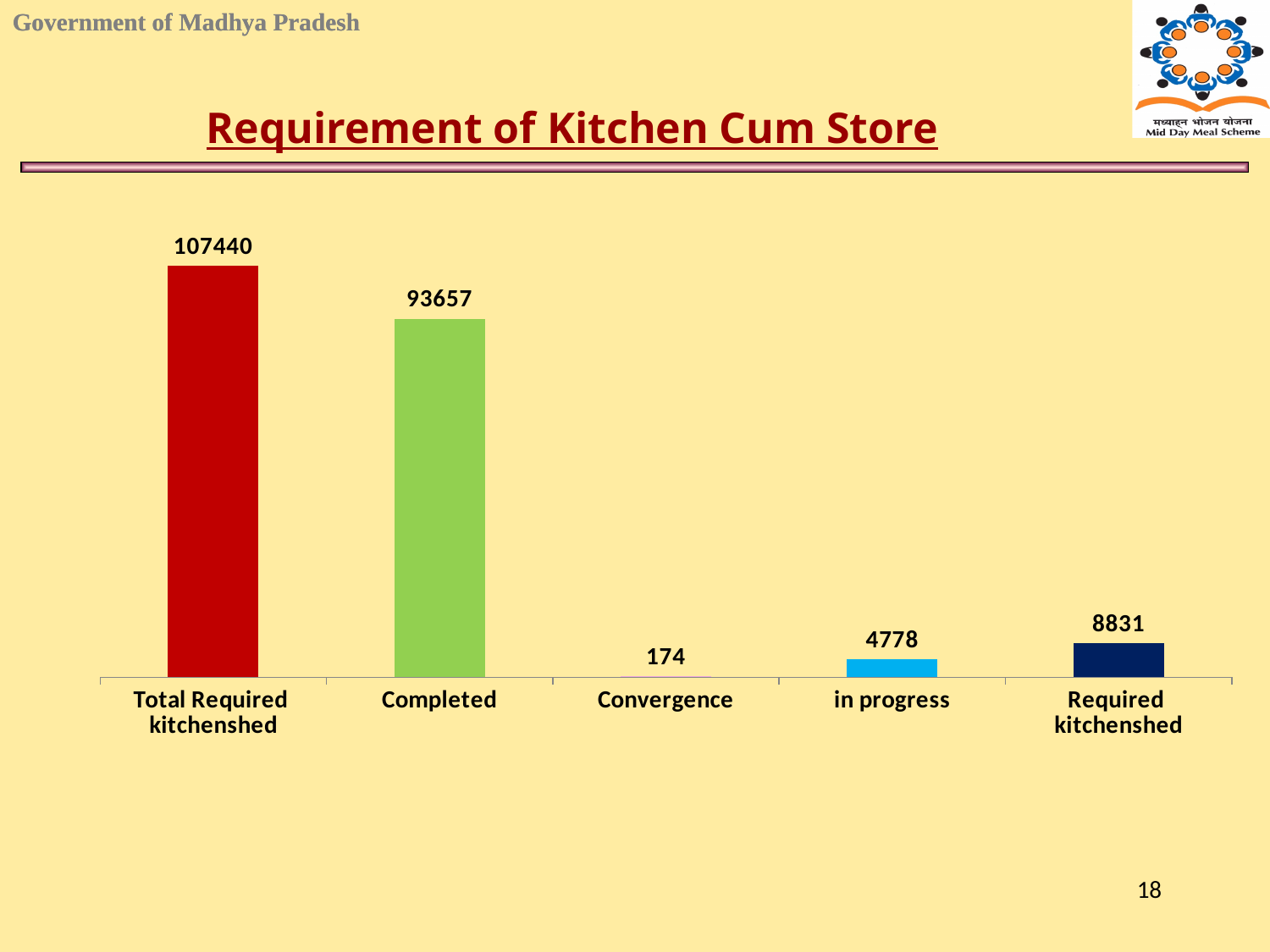
What is the value for in progress? 4778 What is the value for Required kitchenshed? 8831 Which category has the lowest value? Convergence Which is larger, in progress or Required kitchenshed? Required kitchenshed What is the difference between Total Required kitchenshed and Completed? 13783 What is the difference between Required kitchenshed and in progress? 4053 How many categories are shown on the chart? 5 What is the value for Completed? 93657 What kind of chart is shown on the slide? Bar chart What is the value for Total Required kitchenshed? 107440 Which category has the highest value? Total Required kitchenshed What is the value for Convergence? 174